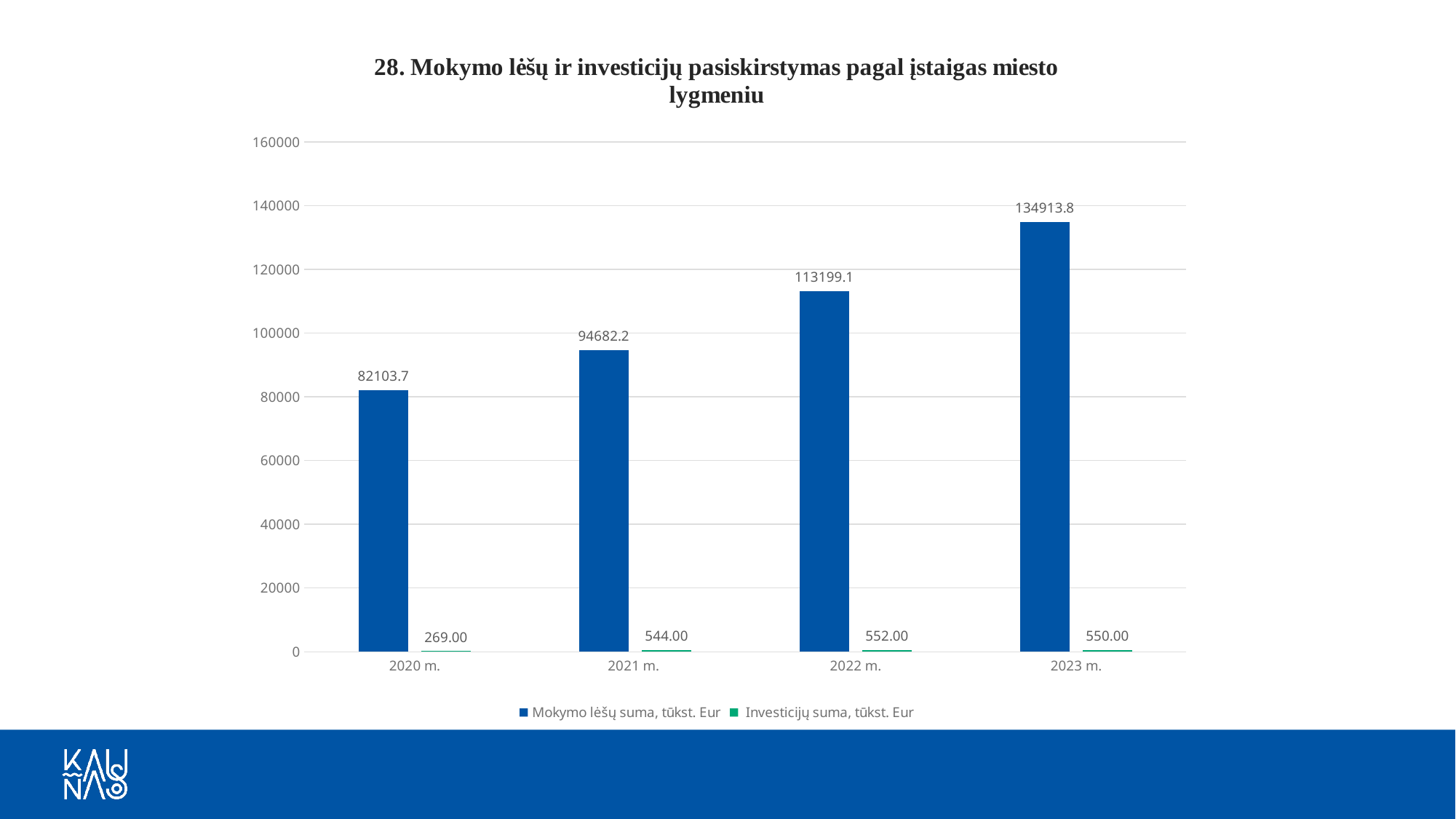
What is the value of Investicijų suma, tūkst. Eur for 2021 m.? 544.00 What is the difference between Mokymo lėšų suma, tūkst. Eur in 2023 m. and 2020 m.? 52810.1 Which is larger: Investicijų suma, tūkst. Eur in 2021 m. or in 2023 m.? 2023 m. Is the value of Mokymo lėšų suma, tūkst. Eur for 2022 m. greater or less than 100000? greater Which year has the lowest Investicijų suma, tūkst. Eur? 2020 m. How many series does the legend list? 2 How many years are shown on the x axis? 4 What is the value of Mokymo lėšų suma, tūkst. Eur for 2023 m.? 134913.8 Does Mokymo lėšų suma, tūkst. Eur rise or fall from 2020 m. to 2023 m.? rise What is the value of Mokymo lėšų suma, tūkst. Eur for 2020 m.? 82103.7 What is the difference between Investicijų suma, tūkst. Eur in 2022 m. and 2021 m.? 8.00 Which year has the highest Mokymo lėšų suma, tūkst. Eur? 2023 m.